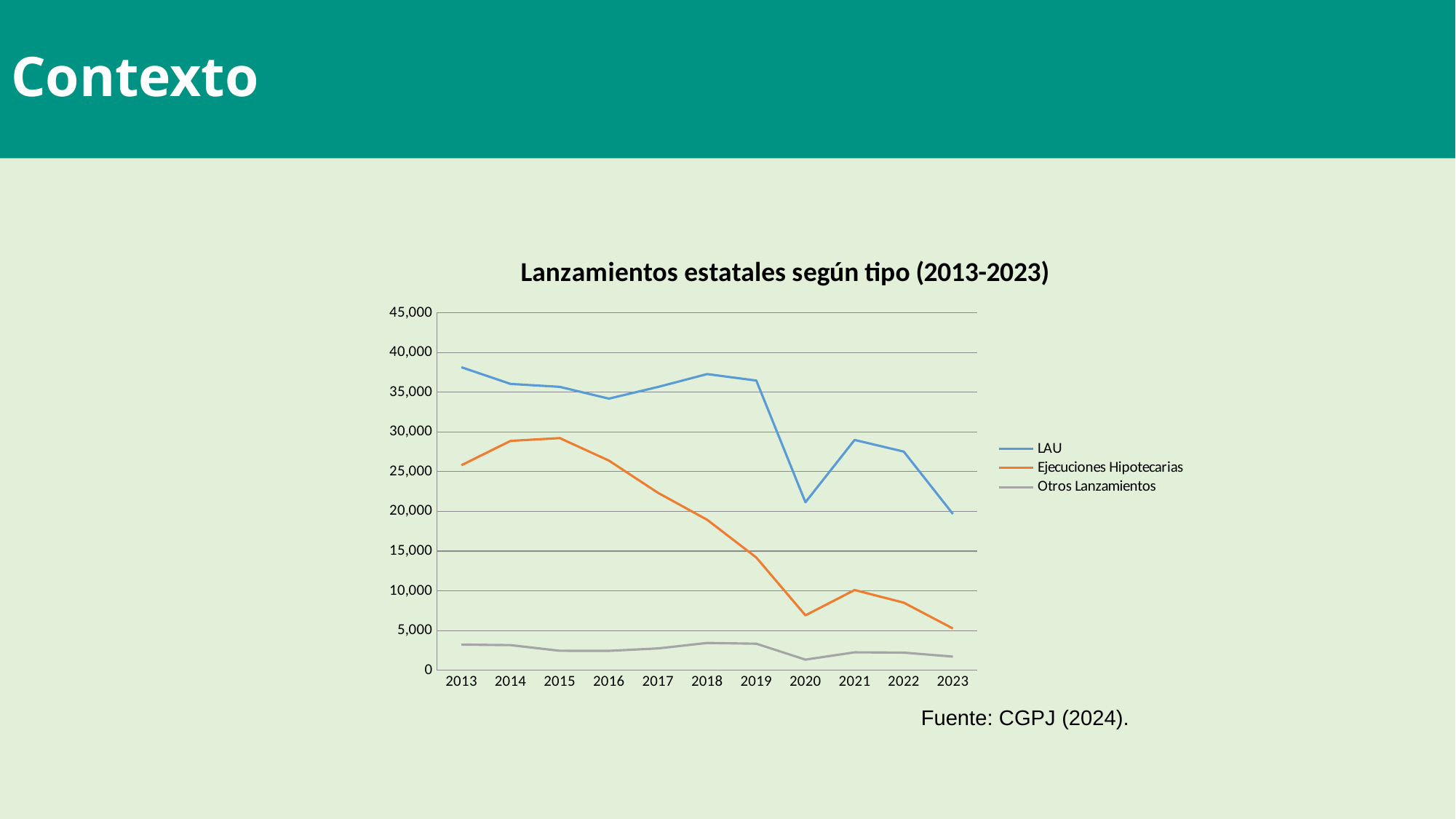
What is the title of the chart? Lanzamientos estatales según tipo (2013-2023) Which series is drawn with the orange line? Ejecuciones Hipotecarias Is the value for Otros Lanzamientos in 2018 greater or less than 5,000? less In which year is the value for Ejecuciones Hipotecarias lowest? 2023 Is the value for LAU in 2020 greater or less than 25,000? less How many years are plotted along the x axis? 11 Is the value for LAU in 2013 greater or less than 35,000? greater In which year is the value for LAU lowest? 2023 How many series does the legend list? 3 Which series has the larger value in 2013, LAU or Ejecuciones Hipotecarias? LAU What kind of chart is shown on the slide? line chart